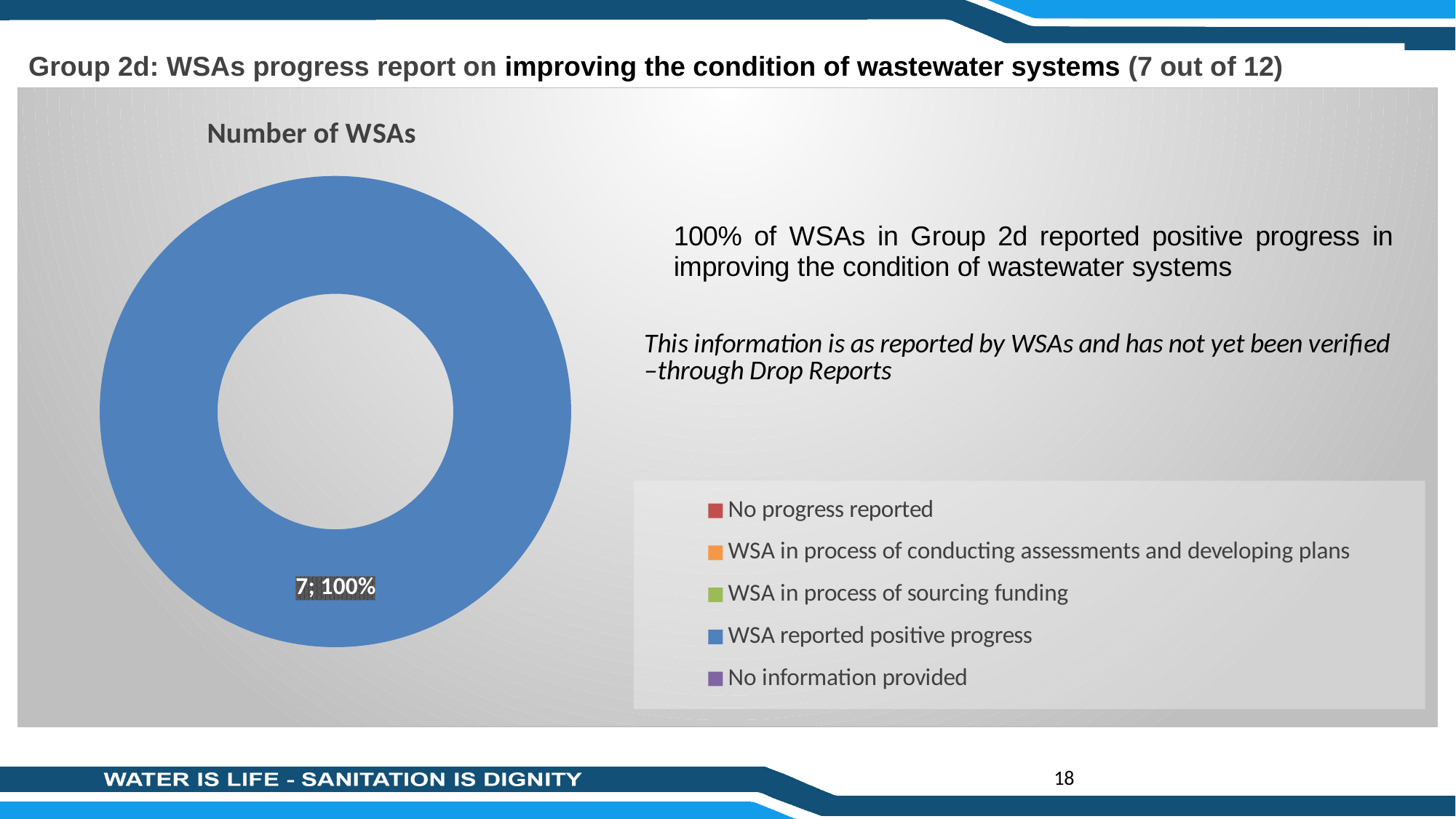
What share of the chart does the 'WSA reported positive progress' slice represent? 100% How many legend entries does the chart list? 5 How many slices are visibly plotted in the chart? 1 How many WSAs are in the 'WSA reported positive progress' slice? 7 Which category makes up the entire chart? WSA reported positive progress What is the title of the chart? Number of WSAs What is the data label shown on the chart's slice? 7; 100% What colour is the 'WSA reported positive progress' slice? Blue What kind of chart is shown on the slide? Doughnut (pie) chart